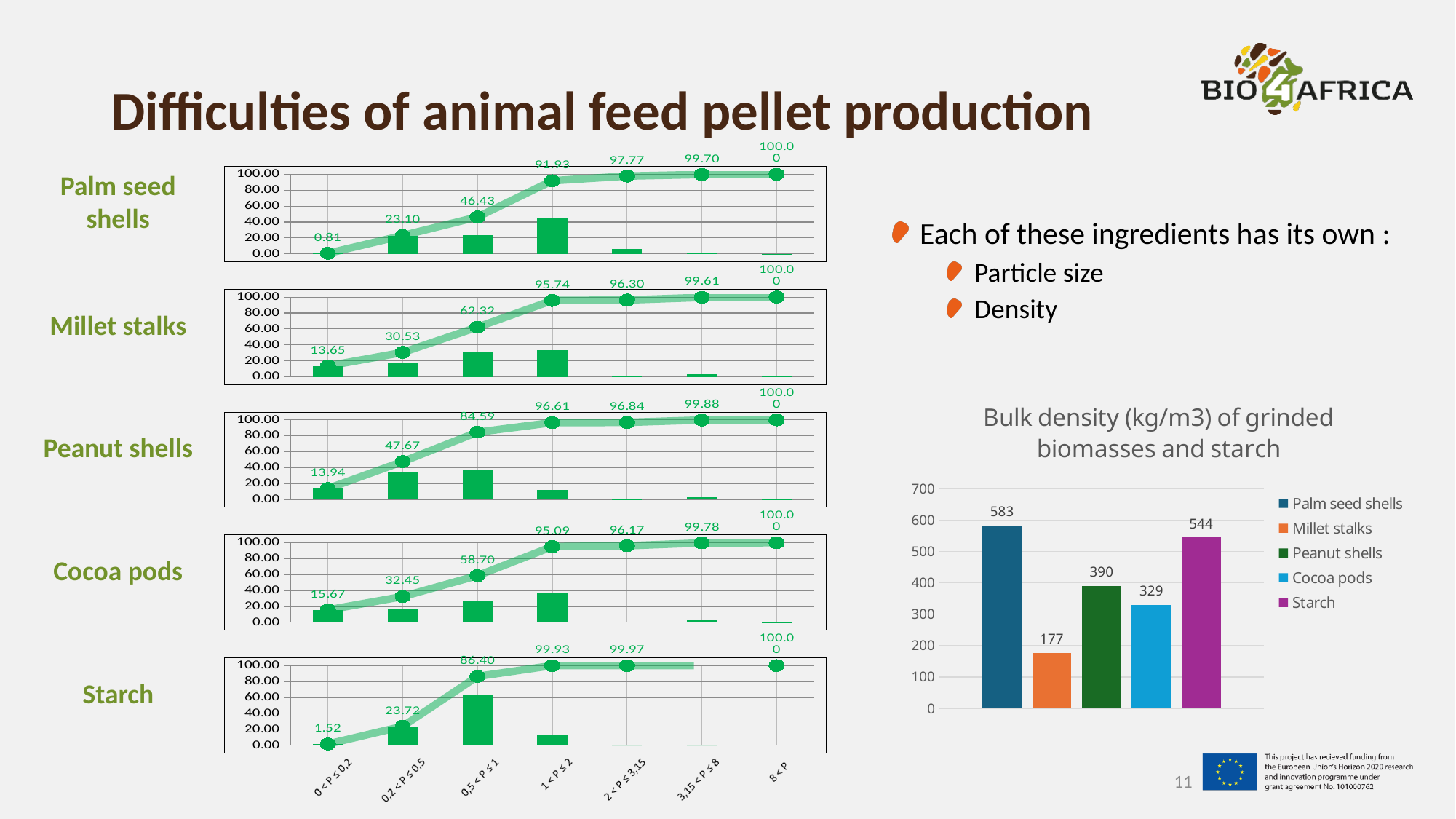
How many particle size categories are shown on the x axis of the Cocoa pods chart? 7 What kind of chart is the Bulk density chart? Bar chart In the Bulk density chart, what is the bulk density of Palm seed shells? 583 In the Bulk density chart, which material has the highest bulk density? Palm seed shells In the Starch chart, does the cumulative line rise or fall along the x axis? Rise In the Bulk density chart, which material has the lowest bulk density? Millet stalks In the Palm seed shells chart, what is the cumulative value labelled at the 0,5 < P ≤ 1 category? 46.43 How many entries does the legend of the Bulk density chart list? 5 In the Bulk density chart, which is larger: the bulk density of Peanut shells or Cocoa pods? Peanut shells In the Millet stalks chart, what is the cumulative value labelled at the 1 < P ≤ 2 category? 95.74 In the Peanut shells chart, what is the cumulative value labelled at the 0,2 < P ≤ 0,5 category? 47.67 In the Bulk density chart, what is the difference between the bulk density of Starch and Cocoa pods? 215